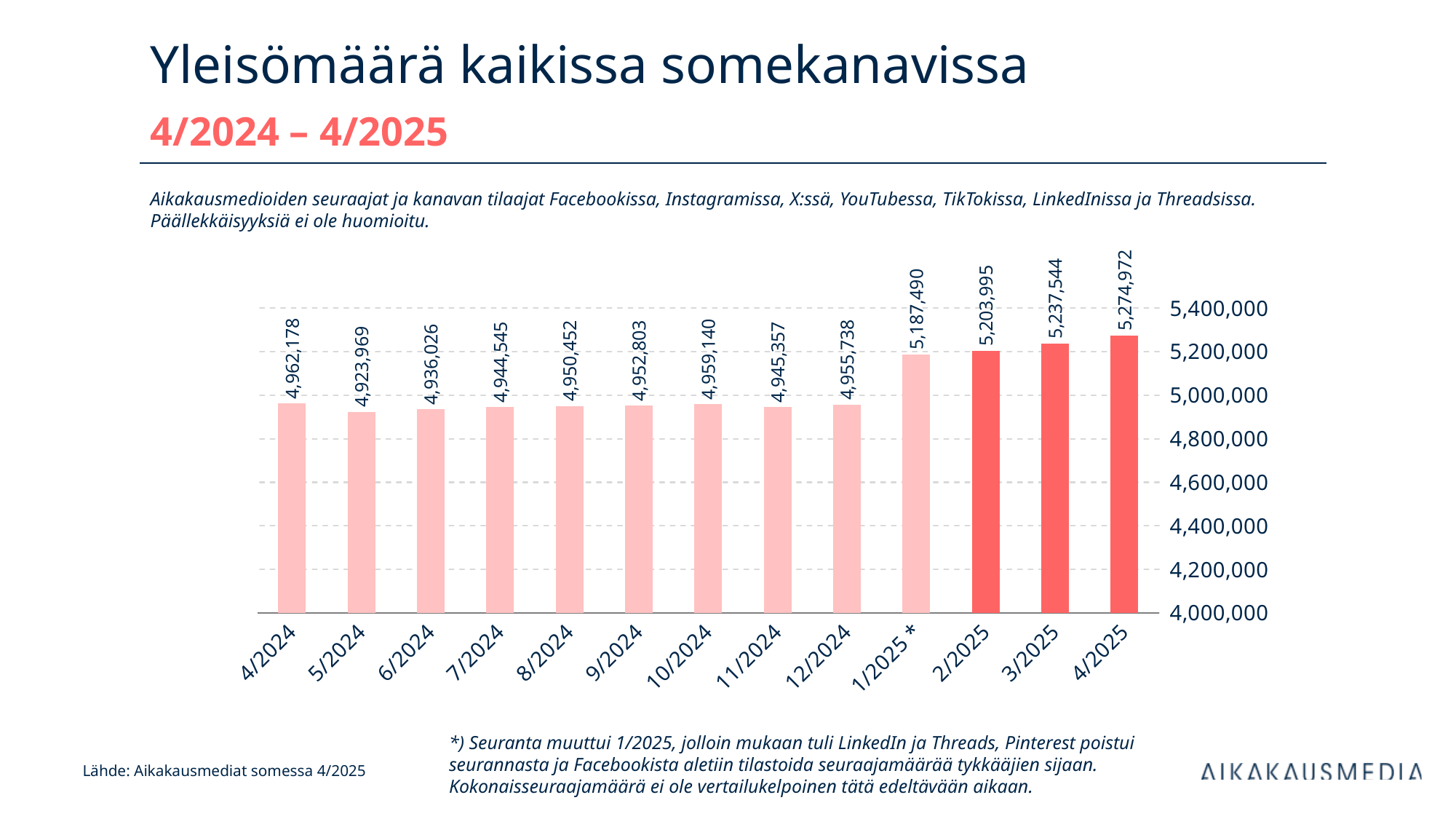
What is the value for 1/2025 *? 5,187,490 What is the value for 4/2025? 5,274,972 What kind of chart is shown on the slide? bar chart What is the difference between the values for 4/2025 and 4/2024? 312,794 Which month has the lowest value? 5/2024 Do the values rise or fall from 1/2025 * to 4/2025? rise What is the value for 5/2024? 4,923,969 How many months are shown on the x axis? 13 What is the difference between the values for 3/2025 and 2/2025? 33,549 Is the value for 12/2024 greater or less than 5,000,000? less Which month has the highest value? 4/2025 Which is larger, the value for 10/2024 or the value for 11/2024? 10/2024